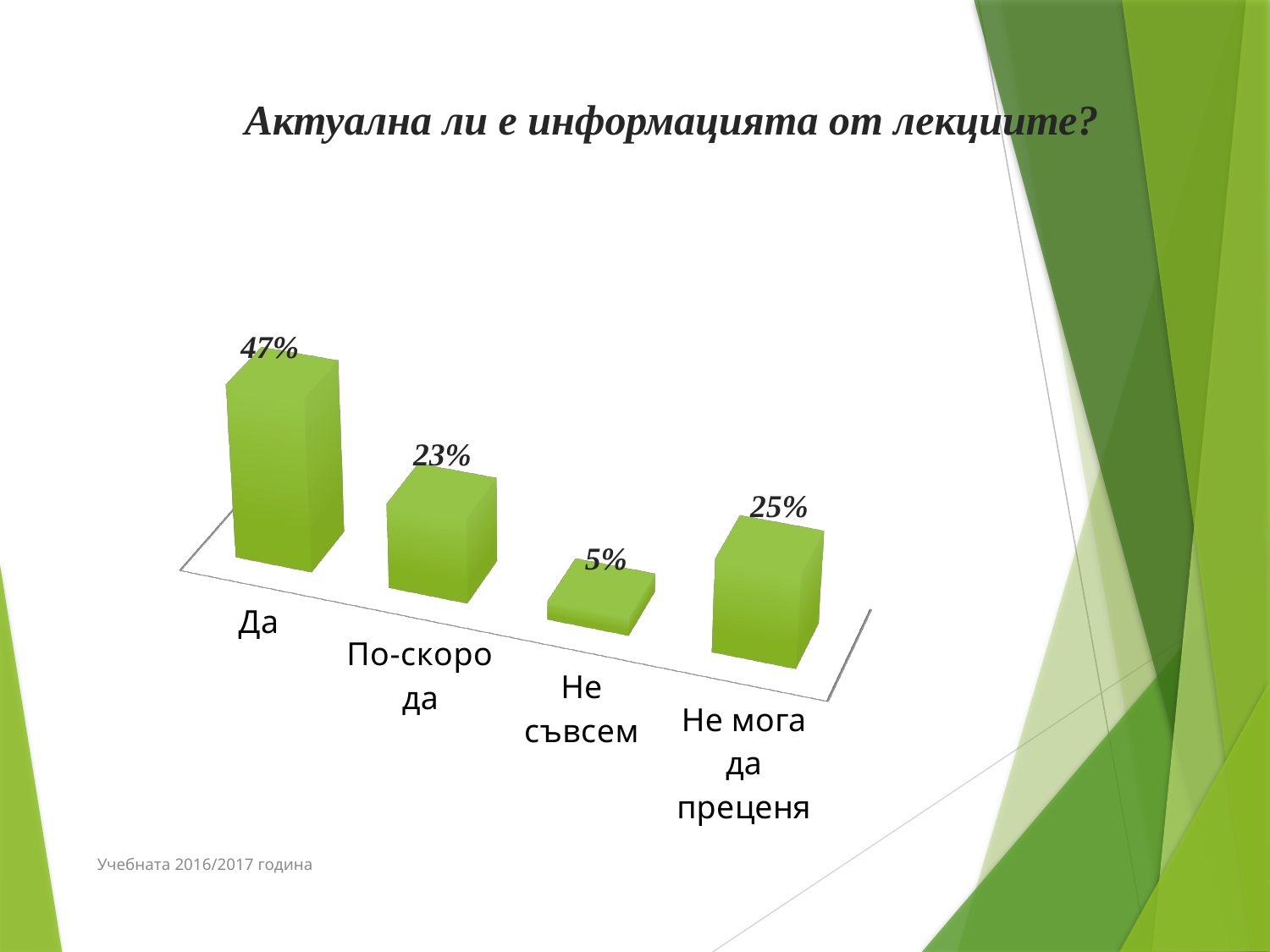
What is the value for "Не мога да преценя"? 25% Which category has the lowest value? Не съвсем What is the title of the chart? Актуална ли е информацията от лекциите? What is the value for "Да"? 47% What is the value for "Не съвсем"? 5% What is the difference between the values for "Не мога да преценя" and "Не съвсем"? 20% Which is larger, the value for "По-скоро да" or the value for "Не мога да преценя"? Не мога да преценя What is the value for "По-скоро да"? 23% What kind of chart is shown on the slide? bar chart Which category has the highest value? Да How many categories are shown in the chart? 4 What is the difference between the values for "Да" and "По-скоро да"? 24%